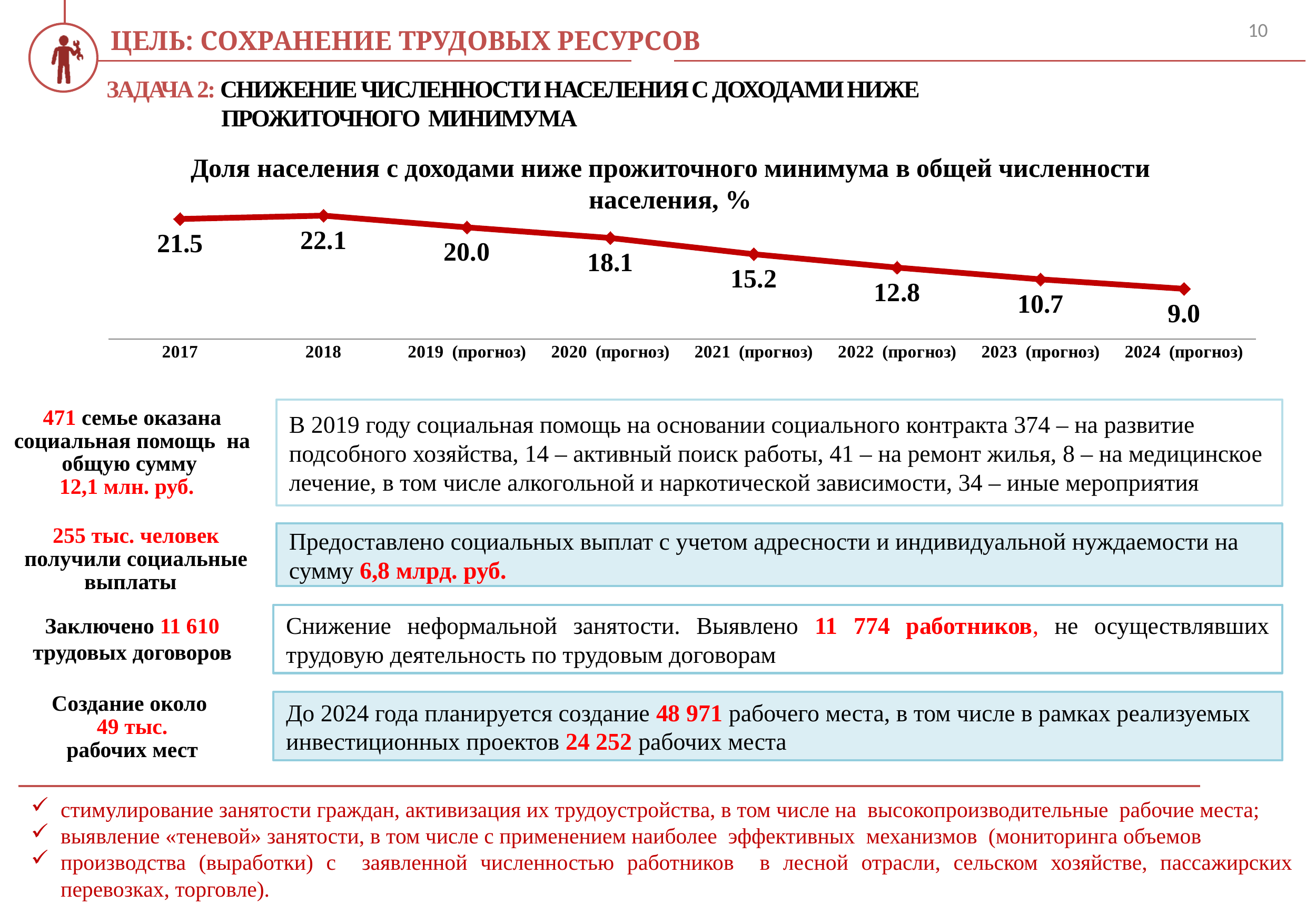
What is the value for 2021 (прогноз) on the chart? 15.2 What is the value for 2018 on the chart? 22.1 Which year has the highest value on the chart? 2018 What is the value for 2017 on the chart? 21.5 What is the difference between the values for 2018 and 2024 (прогноз)? 13.1 Which year has the lowest value on the chart? 2024 (прогноз) What is the difference between the values for 2019 (прогноз) and 2020 (прогноз)? 1.9 Which is larger, the value for 2017 or the value for 2019 (прогноз)? 2017 What is the value for 2024 (прогноз) on the chart? 9.0 How many data points are plotted on the chart? 8 Do the values rise or fall from 2018 to 2024 (прогноз)? fall What kind of chart is shown on the slide? line chart